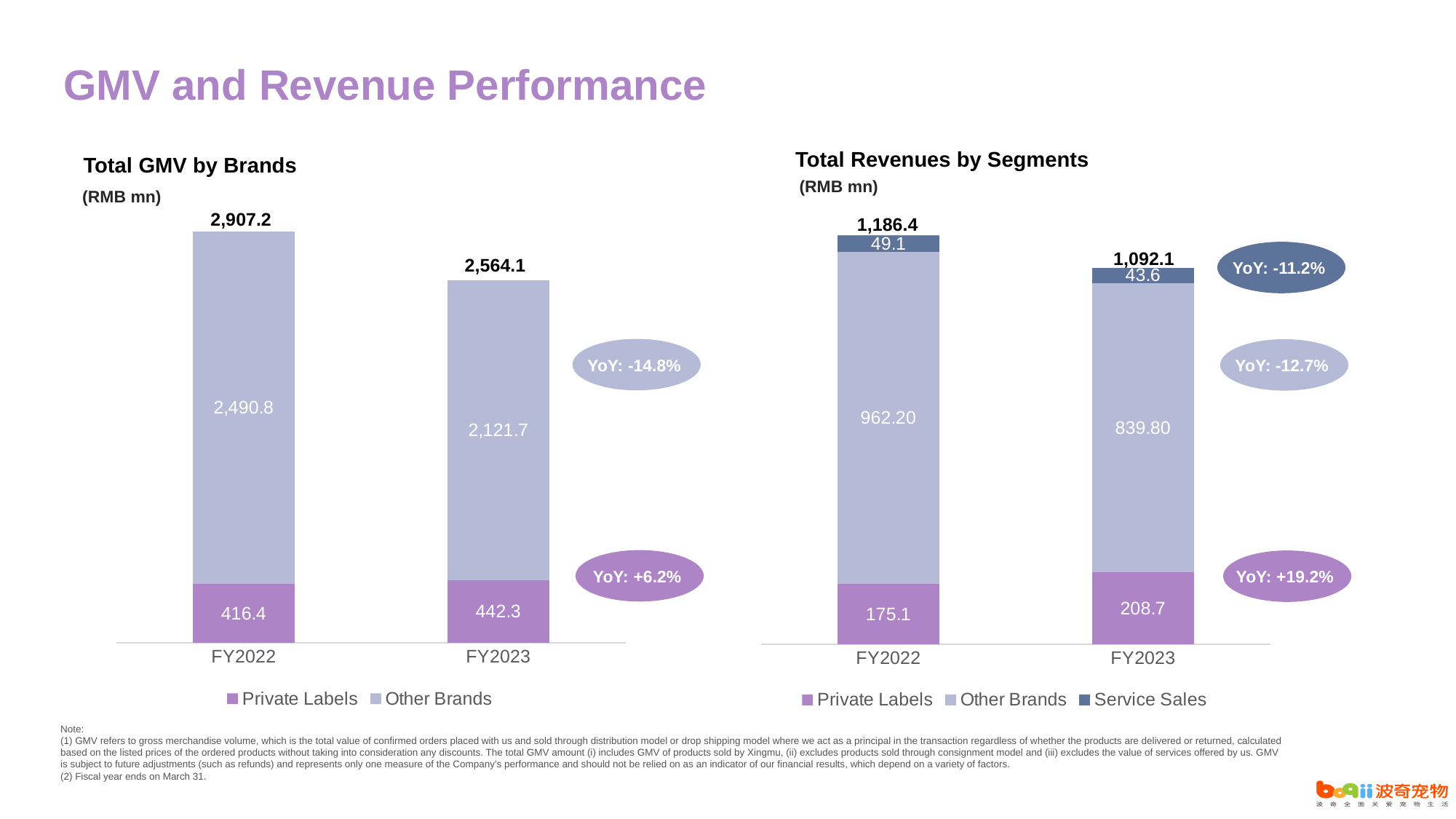
In the Total Revenues by Segments chart, what is the total of the FY2023 stacked bar? 1,092.1 How many series does the legend of the Total Revenues by Segments chart list? 3 In the Total Revenues by Segments chart, what is the value for Other Brands in FY2023? 839.80 In the Total GMV by Brands chart, what is the value for Other Brands in FY2022? 2,490.8 In the Total GMV by Brands chart, which year has the higher Private Labels value, FY2022 or FY2023? FY2023 In the Total GMV by Brands chart, what is the value for Private Labels in FY2023? 442.3 In the Total Revenues by Segments chart, what is the difference between the Private Labels values for FY2023 and FY2022? 33.6 In the Total Revenues by Segments chart, what YoY change is shown for Service Sales? -11.2% In the Total GMV by Brands chart, what is the difference between the Other Brands values for FY2022 and FY2023? 369.1 In the Total Revenues by Segments chart, what is the value for Service Sales in FY2022? 49.1 In the Total GMV by Brands chart, what is the total of the FY2022 stacked bar? 2,907.2 What kind of chart is the Total GMV by Brands chart? Stacked bar chart